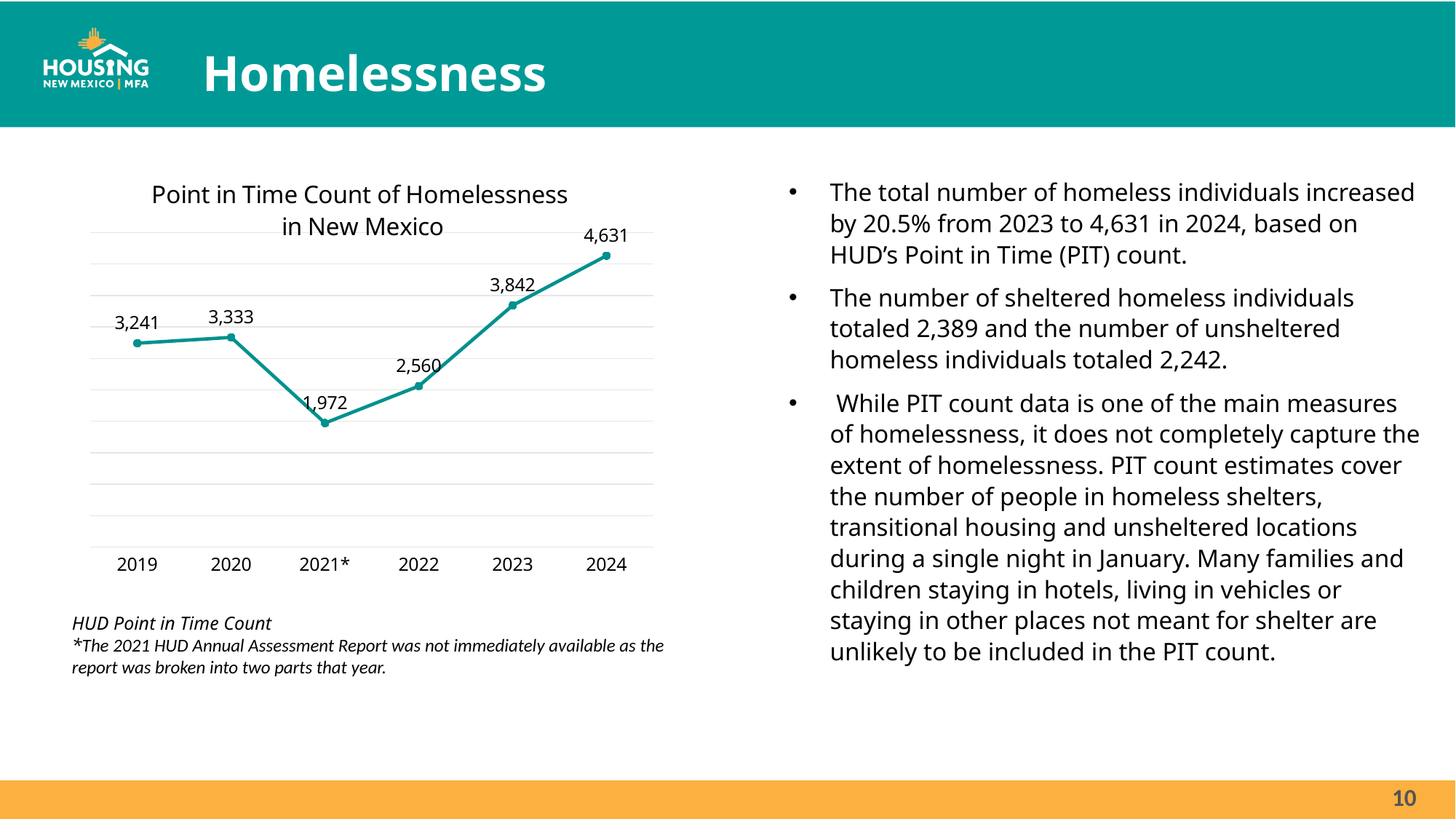
What is the Point in Time count of homelessness in New Mexico for 2024? 4,631 What is the Point in Time count of homelessness in New Mexico for 2019? 3,241 What is the difference between the Point in Time counts for 2020 and 2019? 92 What is the title of the chart on the slide? Point in Time Count of Homelessness in New Mexico Which year has a larger Point in Time count, 2022 or 2020? 2020 Which year has the lowest Point in Time count of homelessness in New Mexico? 2021* What is the difference between the Point in Time counts for 2024 and 2023? 789 What kind of chart is the Point in Time Count of Homelessness in New Mexico? Line chart Which year has the highest Point in Time count of homelessness in New Mexico? 2024 How many years are plotted in the Point in Time Count of Homelessness in New Mexico chart? 6 What is the Point in Time count of homelessness in New Mexico for 2021*? 1,972 Does the Point in Time count rise or fall from 2021* to 2024? Rise